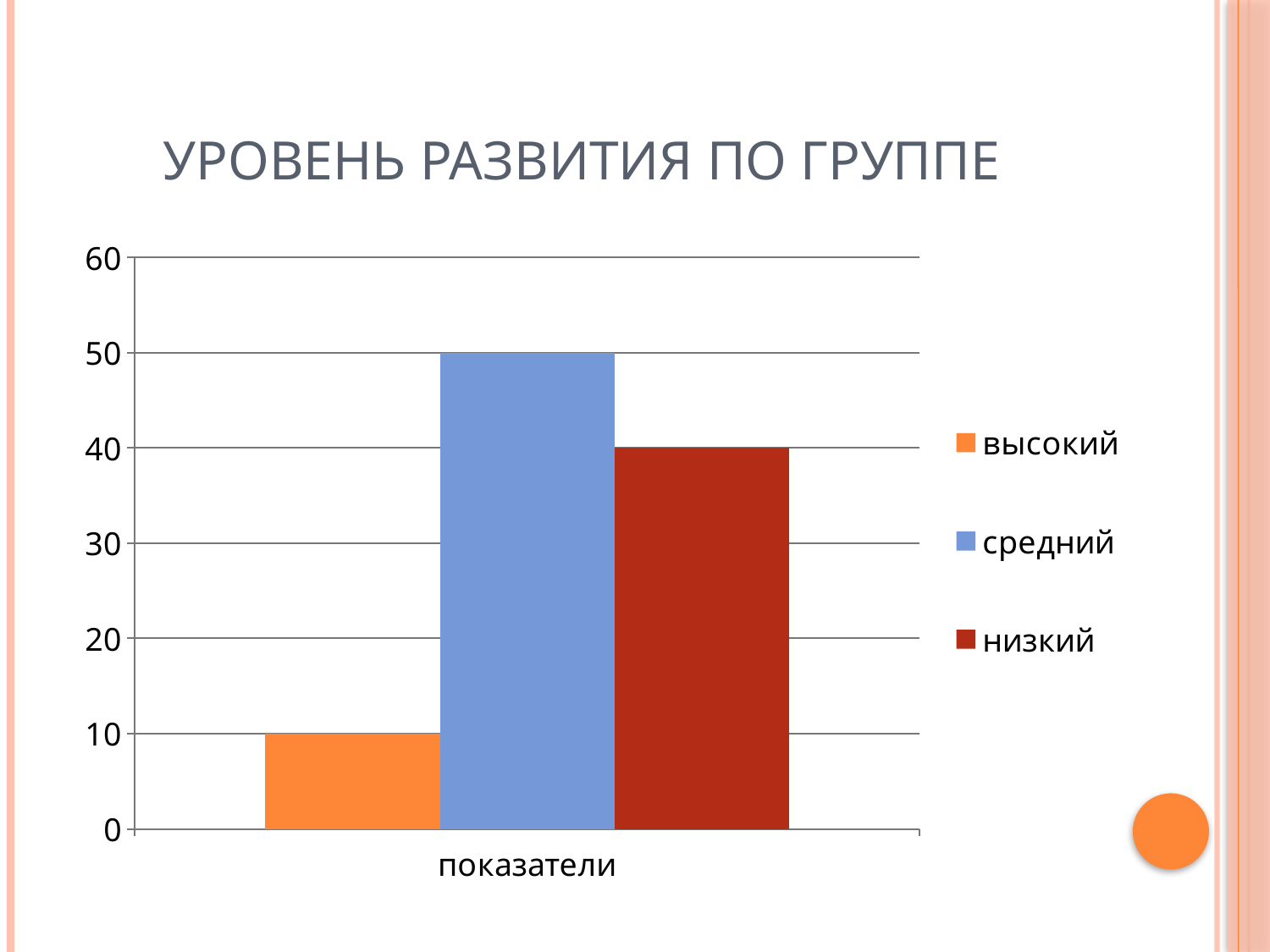
What is the difference between the values for "средний" and "низкий"? 10 Which series has the highest value? средний What is the value for the series "низкий"? 40 Which series has the lowest value? высокий Which is larger, the value for "низкий" or the value for "высокий"? низкий What is the difference between the values for "низкий" and "высокий"? 30 What is the title of the chart on the slide? УРОВЕНЬ РАЗВИТИЯ ПО ГРУППЕ Is the value for "средний" greater or less than 30? greater What is the value for the series "средний"? 50 How many series does the legend list? 3 What is the value for the series "высокий"? 10 What kind of chart is shown on the slide? bar chart